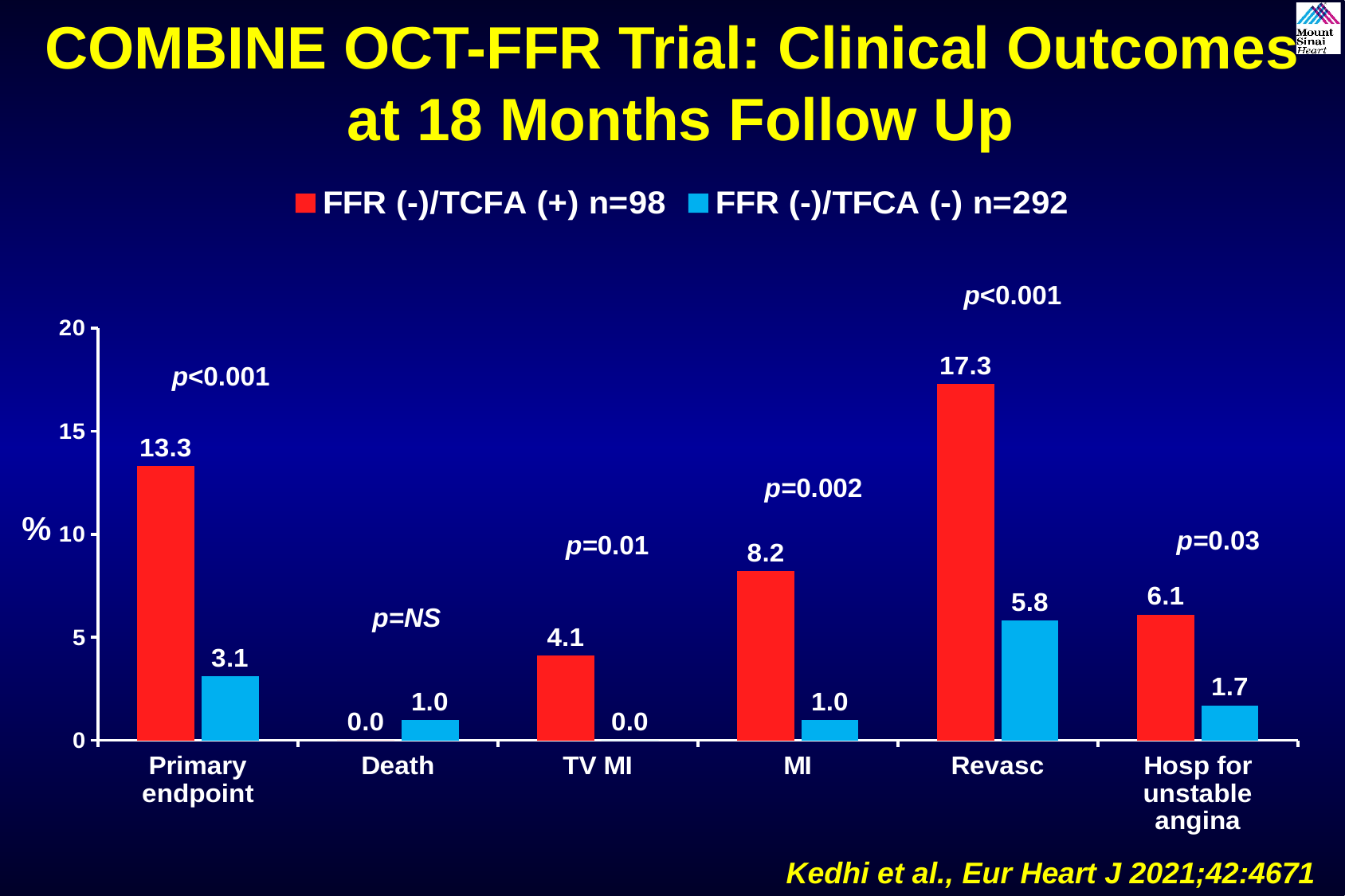
What is the value for the FFR (-)/TFCA (-) n=292 series for the Revasc category? 5.8 What kind of chart is shown on the slide? bar chart For the Death category, which series has the larger value, FFR (-)/TCFA (+) n=98 or FFR (-)/TFCA (-) n=292? FFR (-)/TFCA (-) n=292 Is the FFR (-)/TCFA (+) n=98 value for the MI category greater or less than 10? less What is the value for the FFR (-)/TCFA (+) n=98 series for the Primary endpoint category? 13.3 How many series does the legend list? 2 Which category has the highest value for the FFR (-)/TCFA (+) n=98 series? Revasc What is the difference between the FFR (-)/TCFA (+) n=98 and FFR (-)/TFCA (-) n=292 values for the Revasc category? 11.5 What is the value for the FFR (-)/TCFA (+) n=98 series for the Hosp for unstable angina category? 6.1 Which category has the lowest value for the FFR (-)/TCFA (+) n=98 series? Death How many categories are shown on the x axis of the chart? 6 What is the difference between the FFR (-)/TCFA (+) n=98 and FFR (-)/TFCA (-) n=292 values for the Primary endpoint category? 10.2